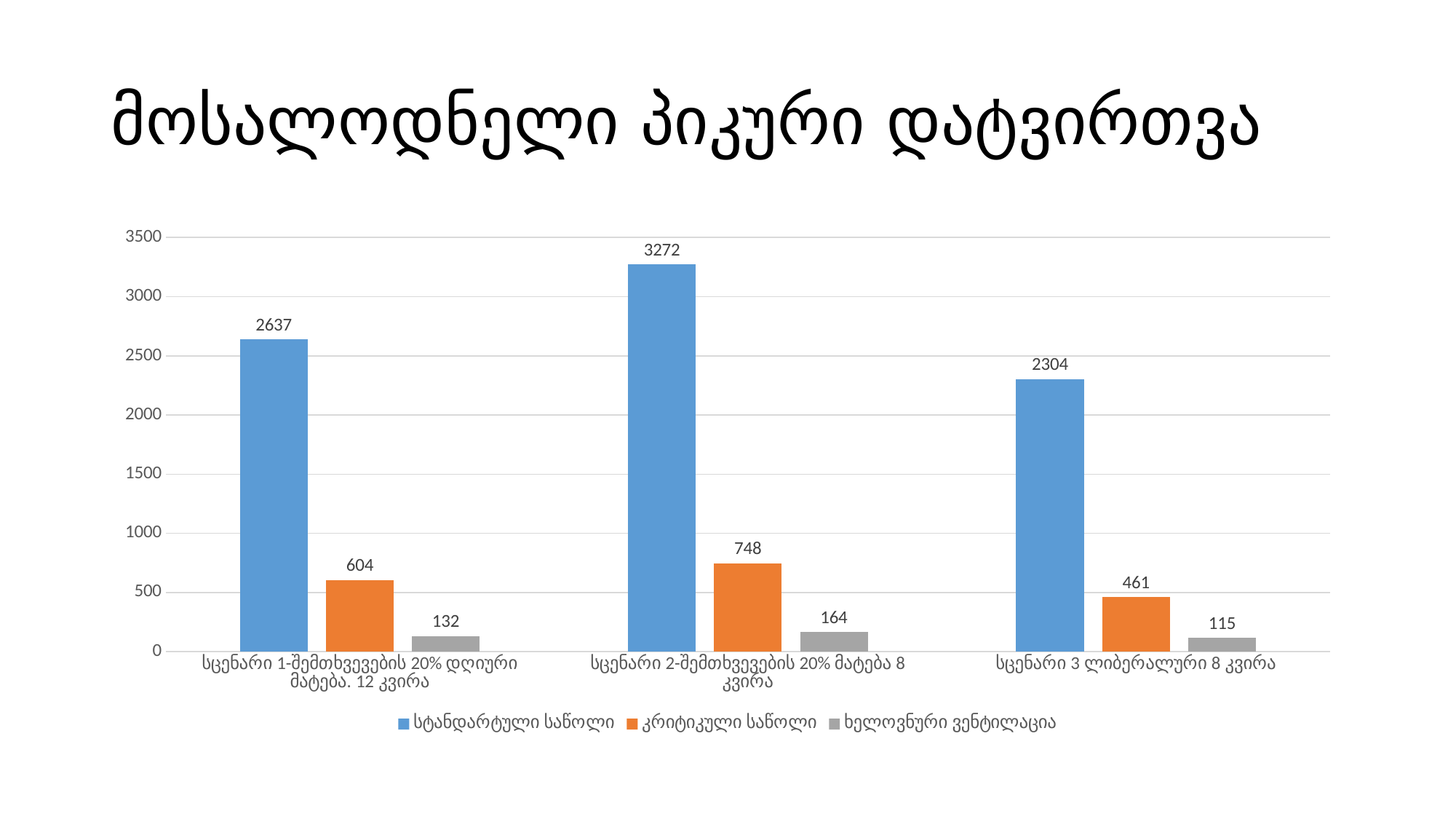
What is the difference between the კრიტიკული საწოლი values for სცენარი 2 and სცენარი 1? 144 Which is larger: კრიტიკული საწოლი for სცენარი 1 or კრიტიკული საწოლი for სცენარი 3? სცენარი 1 What is the value of სტანდარტული საწოლი for სცენარი 2-შემთხვევების 20% მატება 8 კვირა? 3272 Which scenario has the lowest value for ხელოვნური ვენტილაცია? სცენარი 3 ლიბერალური 8 კვირა How many series does the legend list? 3 How many scenarios (categories) are shown on the x axis? 3 What type of chart is shown on the slide? bar chart What is the difference between the სტანდარტული საწოლი values for სცენარი 2 and სცენარი 3? 968 Is the value of სტანდარტული საწოლი for სცენარი 3 ლიბერალური 8 კვირა greater or less than 2500? less Which scenario has the highest value for სტანდარტული საწოლი? სცენარი 2-შემთხვევების 20% მატება 8 კვირა What is the value of ხელოვნური ვენტილაცია for სცენარი 1-შემთხვევების 20% დღიური მატება. 12 კვირა? 132 What is the value of კრიტიკული საწოლი for სცენარი 3 ლიბერალური 8 კვირა? 461